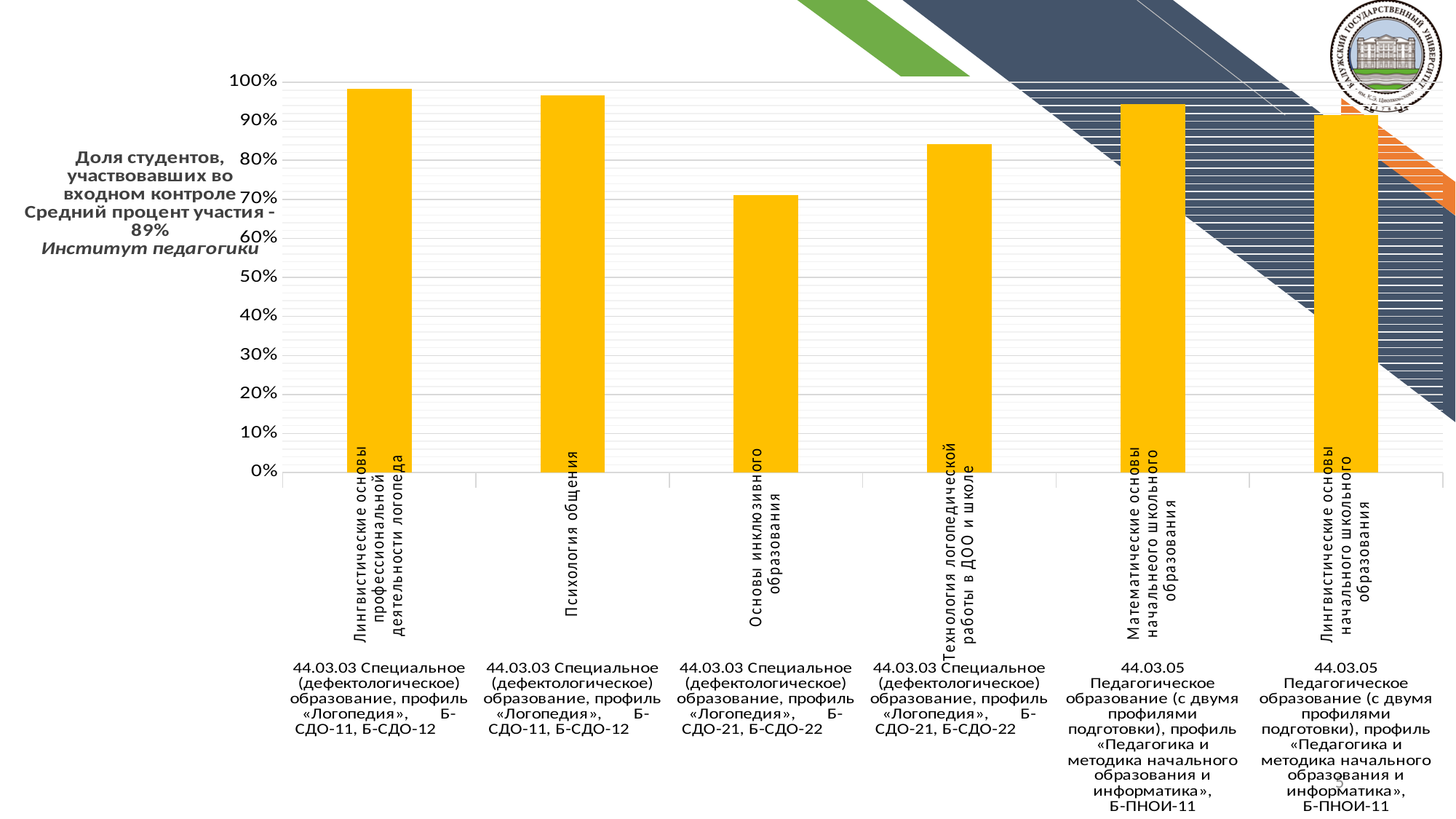
Which discipline has the lowest share of students who took part in the entrance control? Основы инклюзивного образования Which is larger: the value for Психология общения or the value for Основы инклюзивного образования? Психология общения Is the value for Лингвистические основы профессиональной деятельности логопеда greater or less than 90%? greater Is the value for Основы инклюзивного образования greater or less than 80%? less What average participation percentage is stated in the chart's title text? 89% Is the value for Технология логопедической работы в ДОО и школе greater or less than 90%? less What colour are the bars in the chart? yellow Which is larger: the value for Технология логопедической работы в ДОО и школе or the value for Математические основы начального школьного образования? Математические основы начального школьного образования What kind of chart is shown on the slide? bar chart How many bars (disciplines) are plotted in the chart? 6